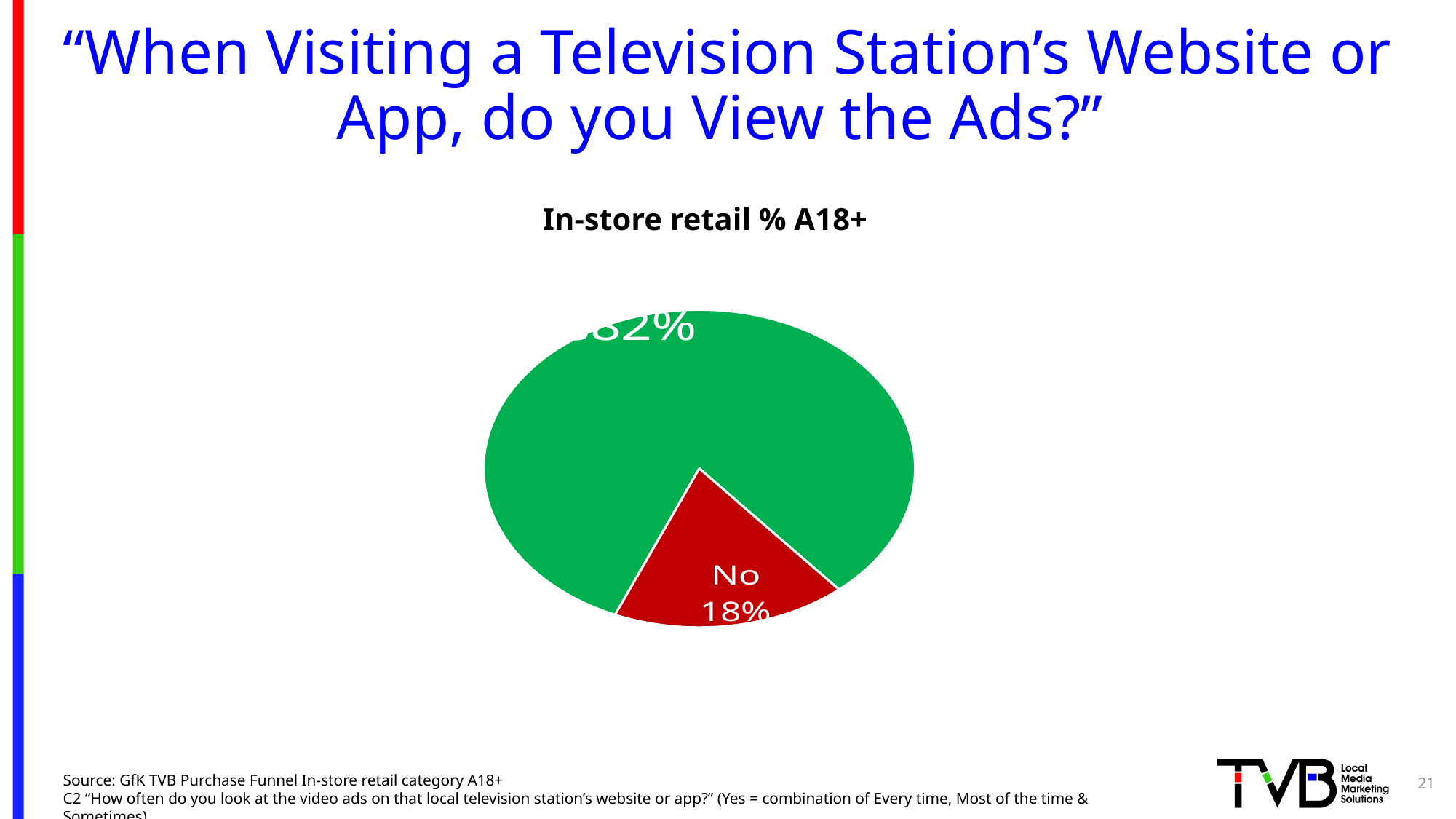
What percentage is shown on the green slice of the pie? 82% Which slice of the pie is the smallest? No How many slices does the pie chart have? 2 What percentage of the pie is labelled "No"? 18% What kind of chart is shown on the slide? pie chart By how many percentage points does the green slice exceed the "No" slice? 64 percentage points Which slice of the pie is the largest? the green slice What is the title of the chart? In-store retail % A18+ Which is larger, the green slice or the "No" slice? the green slice What colour is the "No" slice of the pie? red